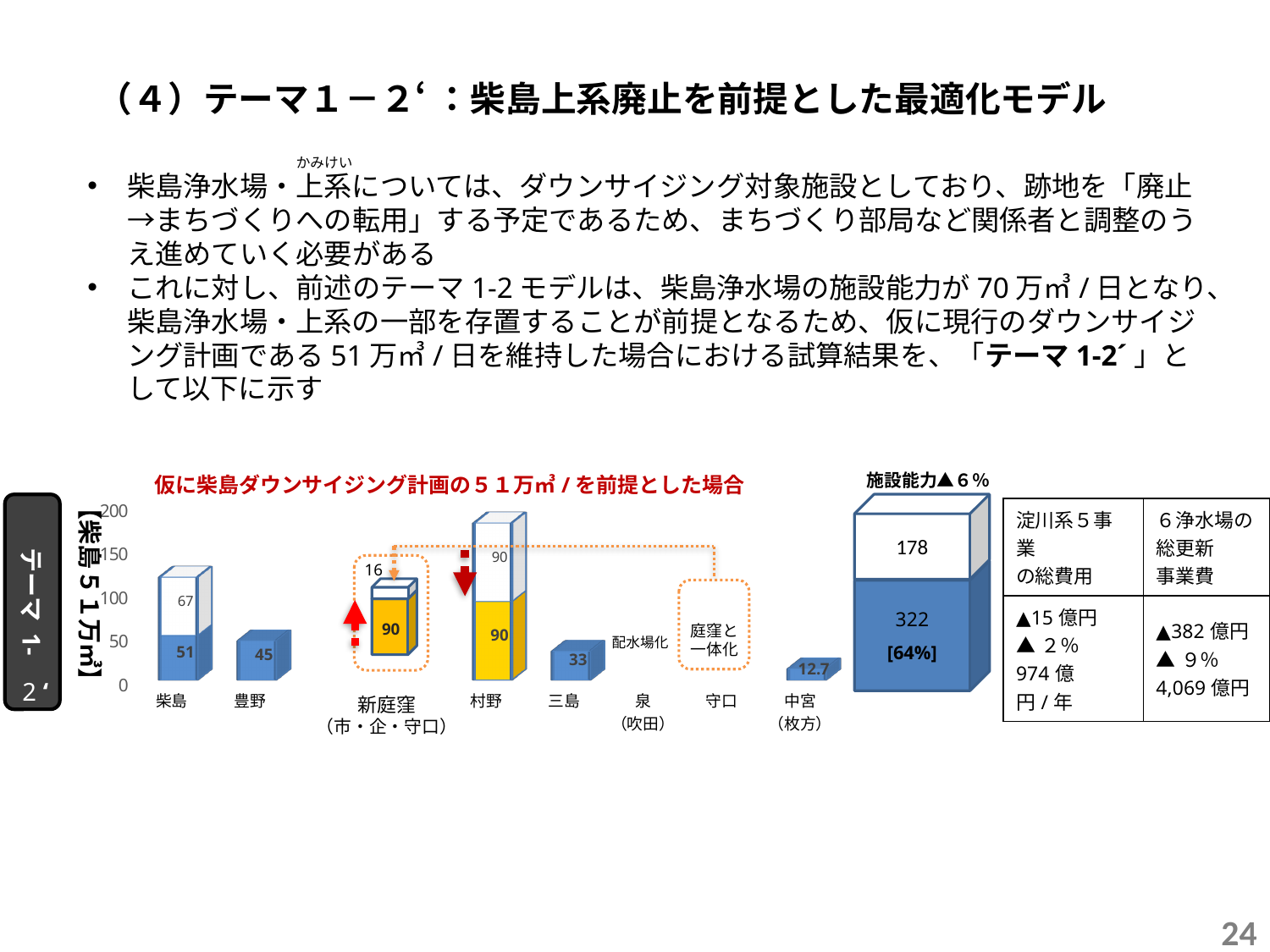
In the left bar chart, what is the value of the white (upper) segment for 新庭窪? 16 In the left bar chart, what is the difference between the value for 豊野 and the value for 三島? 12 In the left bar chart, what is the total of the stacked bar for 柴島? 118 In the left bar chart, what is the total of the stacked bar for 村野? 180 In the left bar chart, what is the value for 豊野? 45 What kind of chart is shown on the left of the slide? bar chart In the left bar chart, what is the value for 中宮? 12.7 In the left bar chart, which is larger, the value for 豊野 or the value for 三島? 豊野 In the left bar chart, what is the value of the white (upper) segment for 柴島? 67 In the right-hand stacked bar (施設能力▲6%), what percentage is shown for the 322 segment? 64% In the left bar chart, what is the value of the blue (lower) segment for 柴島? 51 In the left bar chart, is the total bar height for 村野 greater or less than 150? greater